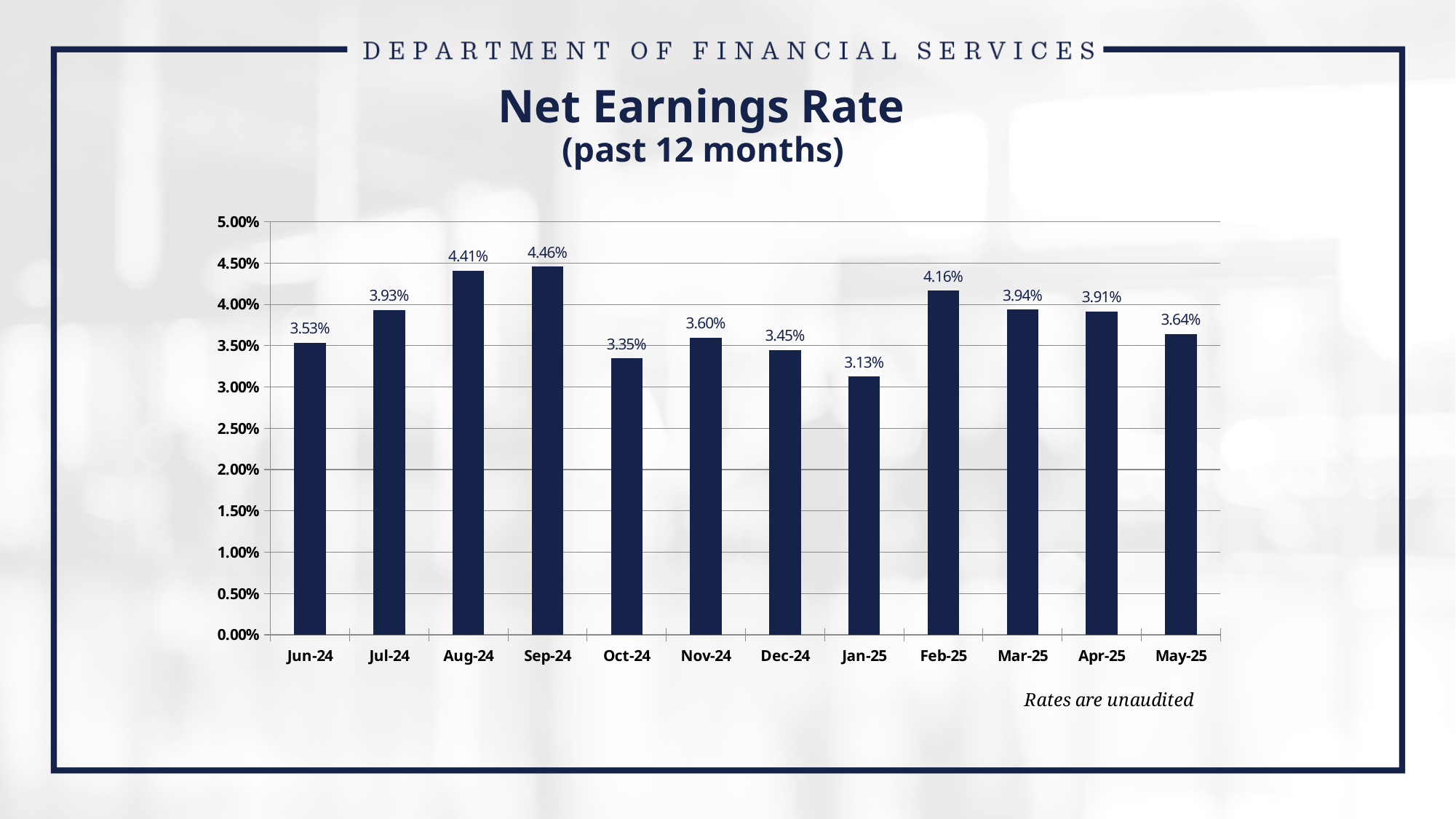
What kind of chart is shown on the slide? bar chart What is the net earnings rate for Jan-25? 3.13% What is the difference between the net earnings rate in Sep-24 and Jan-25? 1.33% Which month has a higher net earnings rate, Aug-24 or Feb-25? Aug-24 Which month has the lowest net earnings rate? Jan-25 What is the net earnings rate for Sep-24? 4.46% Is the net earnings rate for Oct-24 greater or less than 3.50%? less Does the net earnings rate rise or fall from Sep-24 to Oct-24? fall What is the title of the chart? Net Earnings Rate (past 12 months) Which month has the highest net earnings rate? Sep-24 What is the net earnings rate for Feb-25? 4.16% How many months are shown on the chart? 12